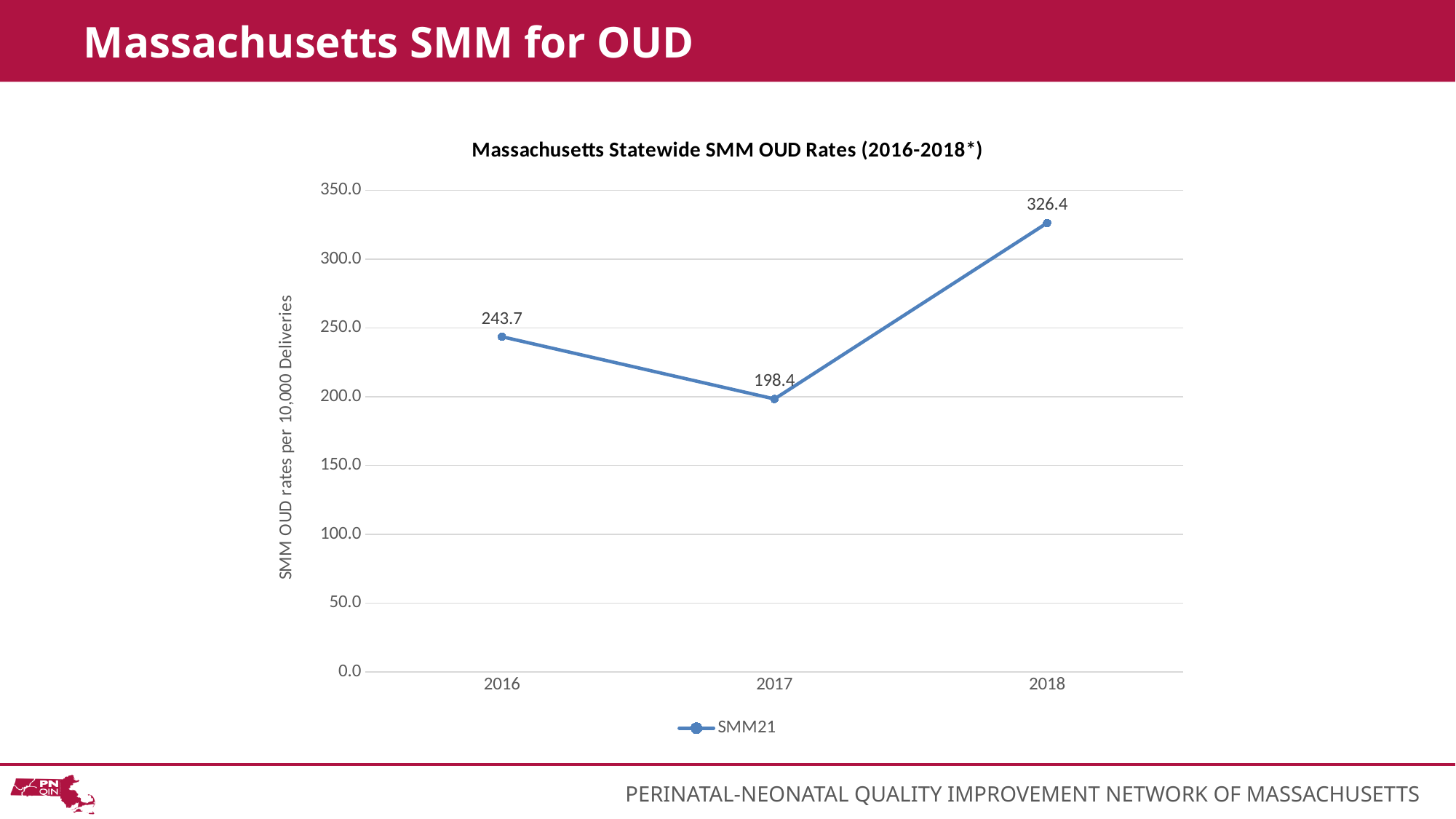
What is the difference between the 2016 and 2017 SMM OUD rates? 45.3 Is the value for 2018 greater or less than 300.0? greater Which year has the lowest SMM OUD rate? 2017 What is the SMM OUD rate for 2016? 243.7 What is the difference between the 2018 and 2017 SMM OUD rates? 128.0 What is the SMM OUD rate for 2017? 198.4 Which year has the highest SMM OUD rate? 2018 What kind of chart is shown on the slide? line chart Which year has a higher SMM OUD rate, 2016 or 2018? 2018 How many years are plotted on the chart? 3 What is the SMM OUD rate for 2018? 326.4 What series name does the legend show? SMM21